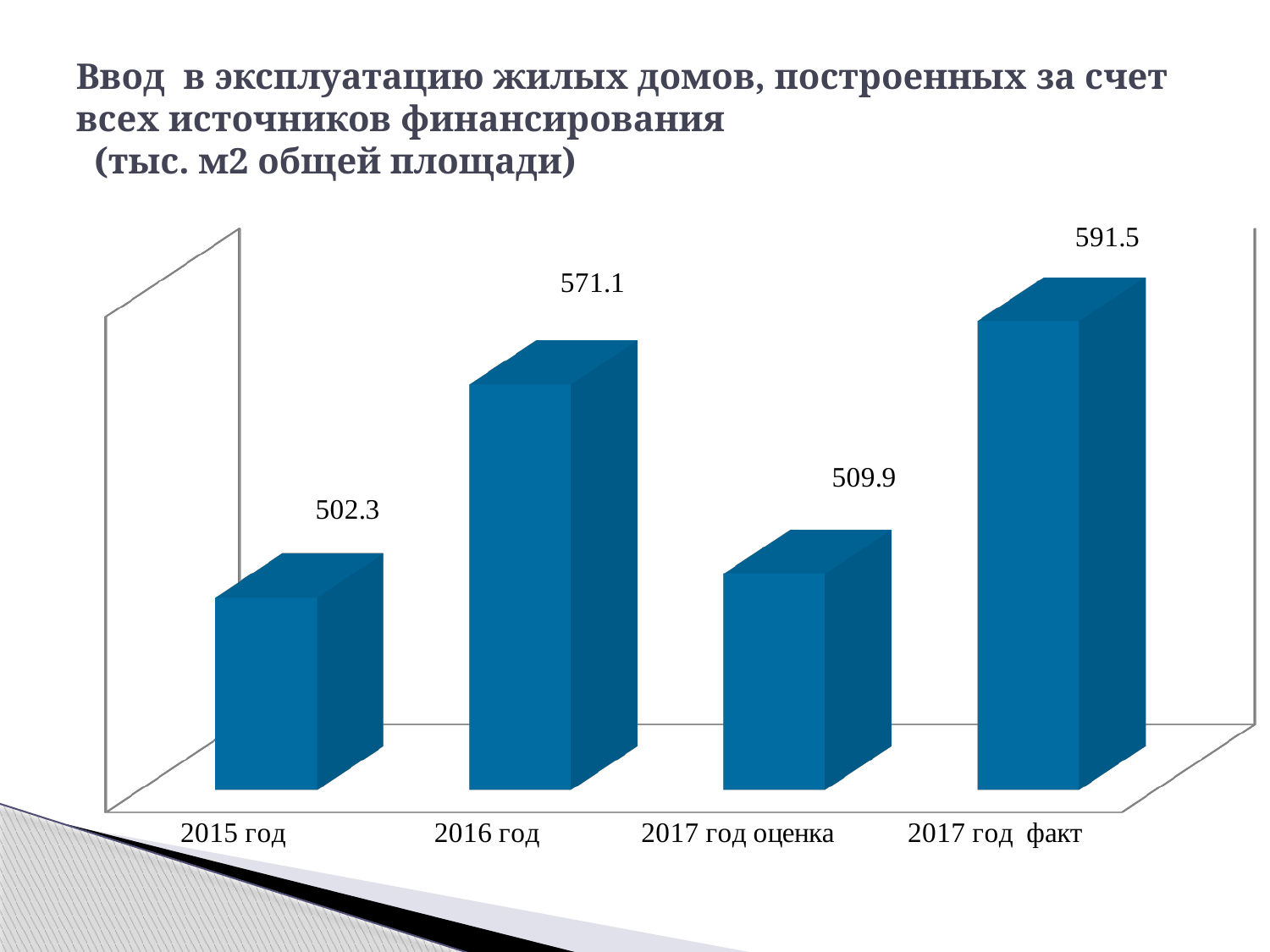
What is the value for 2015 год? 502.3 Which category has the highest value? 2017 год факт Which category has the lowest value? 2015 год What kind of chart is shown on the slide? bar chart What is the value for 2017 год факт? 591.5 What is the difference between the values for 2017 год факт and 2017 год оценка? 81.6 What unit is given in the chart title? тыс. м2 общей площади Which is larger, the value for 2016 год or the value for 2017 год оценка? 2016 год What is the value for 2017 год оценка? 509.9 How many categories are shown on the chart? 4 What is the difference between the values for 2016 год and 2015 год? 68.8 What is the value for 2016 год? 571.1